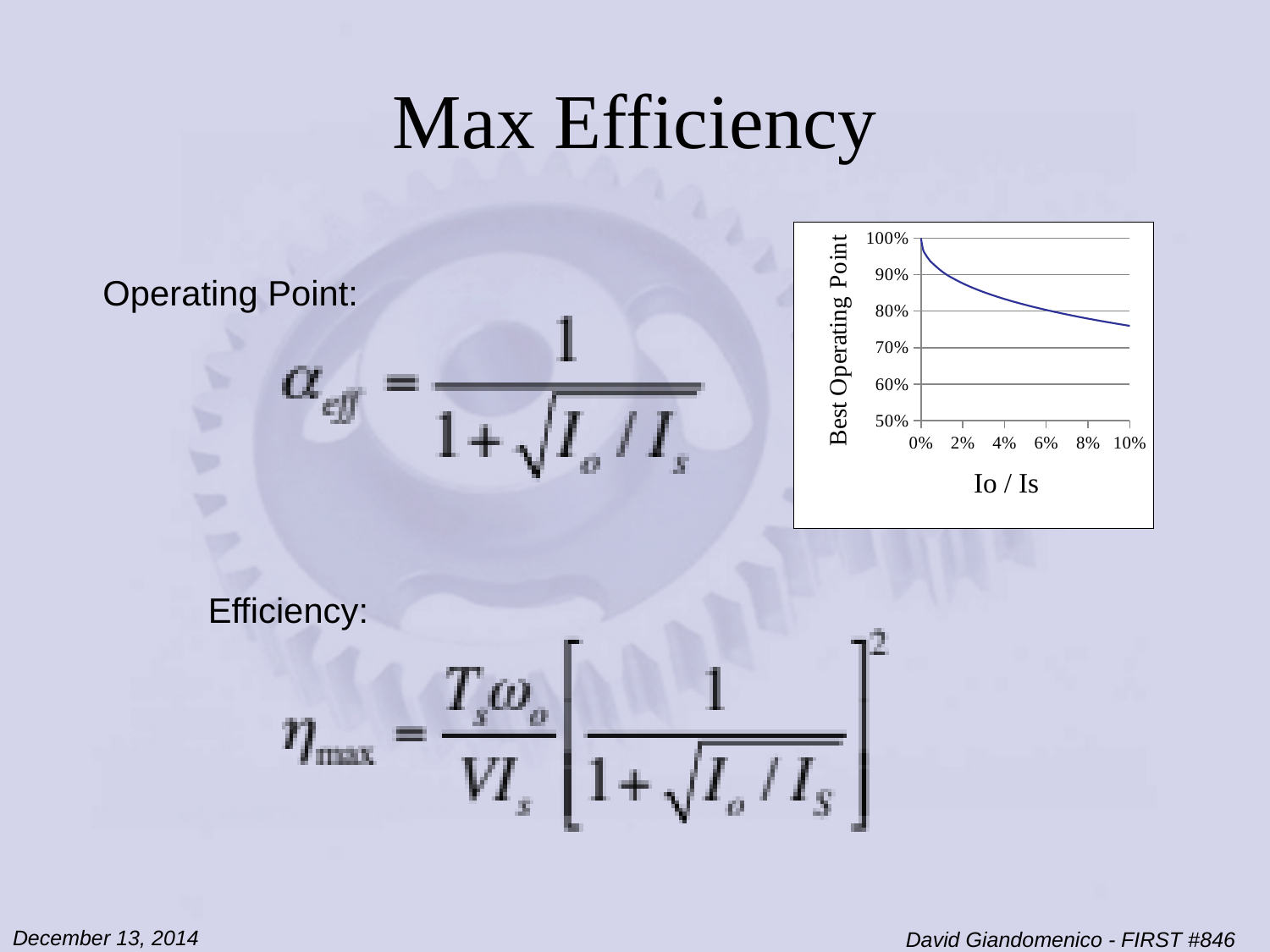
Is the Best Operating Point at Io / Is = 10% greater or less than 70%? greater Is the Best Operating Point at Io / Is = 10% greater or less than 80%? less What kind of chart is shown on the slide? line chart What is the Best Operating Point when Io / Is is 0%? 100% Which is larger, the Best Operating Point at Io / Is = 2% or at Io / Is = 8%? 2% What is the label of the y axis of the chart? Best Operating Point Does the Best Operating Point rise or fall as Io / Is increases? fall At which Io / Is value is the Best Operating Point highest? 0% What is the label of the x axis of the chart? Io / Is Is the Best Operating Point at Io / Is = 4% greater or less than 90%? less At which Io / Is value is the Best Operating Point lowest? 10%